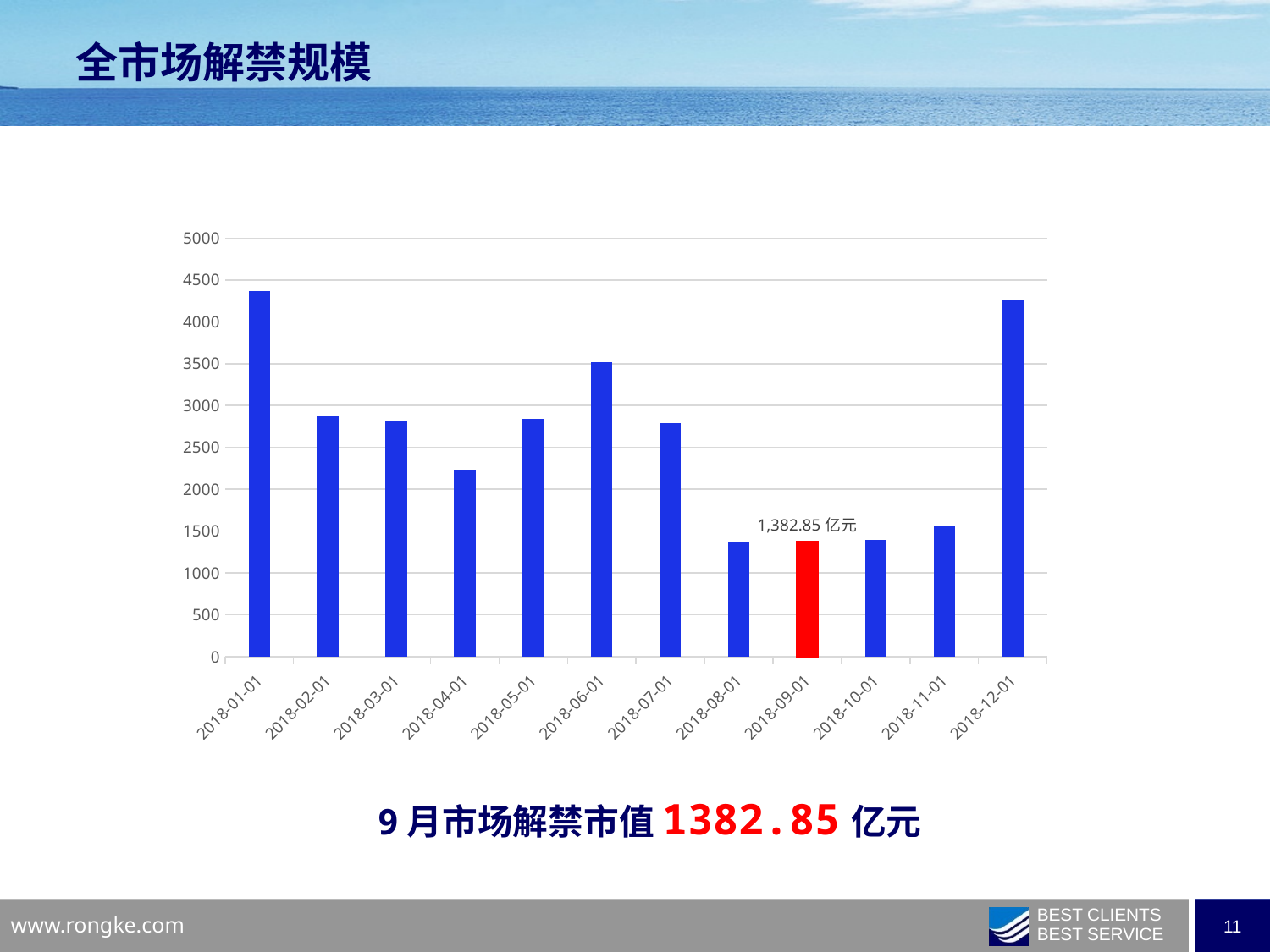
Which is larger, the value for 2018-06-01 or 2018-07-01? 2018-06-01 Which bar in the chart is highlighted in red? 2018-09-01 Is the value for 2018-01-01 greater or less than 4000? greater What type of chart is shown on the slide? bar chart Is the value for 2018-12-01 greater or less than 4000? greater What is the value shown for 2018-09-01? 1,382.85 亿元 What is the title of the slide containing the chart? 全市场解禁规模 How many months (bars) are plotted in the chart? 12 Is the value for 2018-04-01 greater or less than 2500? less Which is larger, the value for 2018-04-01 or 2018-05-01? 2018-05-01